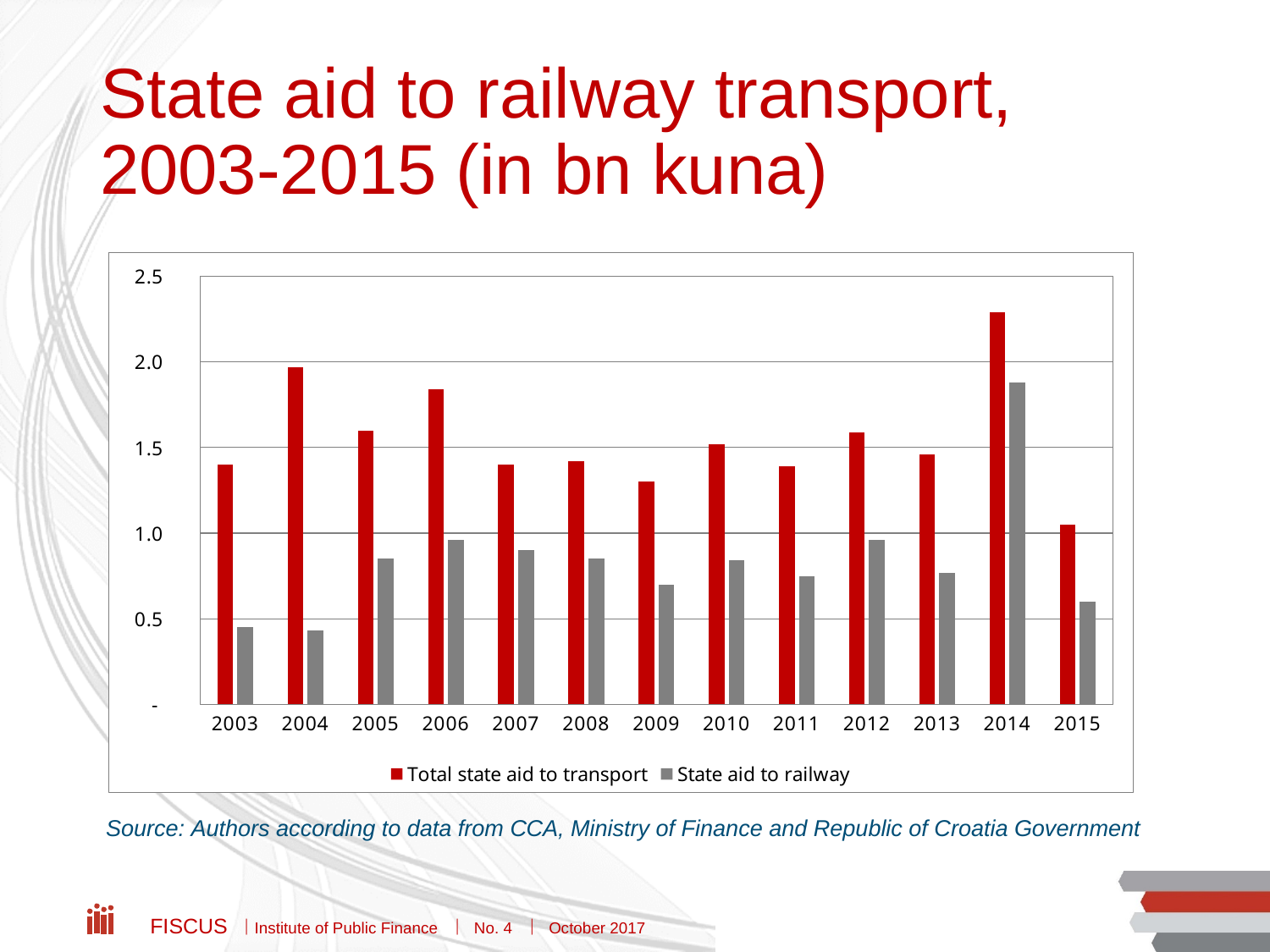
In which year is Total state aid to transport highest? 2014 Is the value for Total state aid to transport in 2009 greater or less than 1.5? less Is the value for State aid to railway in 2003 greater or less than 0.5? less In which year is Total state aid to transport lowest? 2015 Is the value for State aid to railway in 2014 greater or less than 1.5? greater Which is larger: Total state aid to transport in 2004 or in 2006? 2004 Which colour represents State aid to railway in the legend? Grey What kind of chart is shown on the slide? Bar chart In which year is State aid to railway highest? 2014 How many years are shown on the x axis? 13 How many series does the legend list? 2